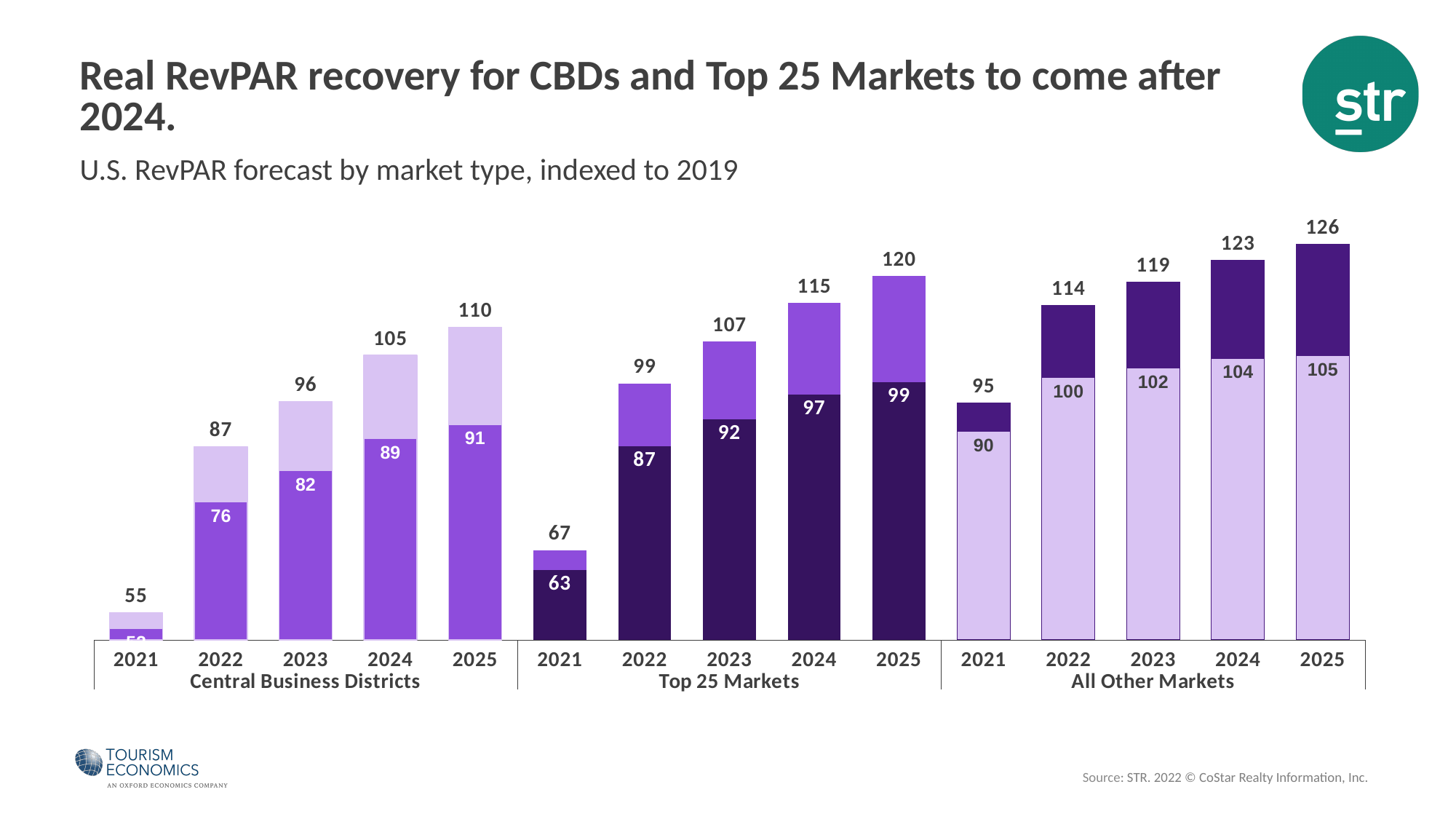
What is the value shown above the 2021 bar for Top 25 Markets? 67 Which is larger: the 2024 total for Central Business Districts or the 2023 total for Top 25 Markets? 2023 total for Top 25 Markets (107) How many market types are shown on the x axis? 3 What is the difference between the total value (120) and the lower segment value (99) of the 2025 bar for Top 25 Markets? 21 What is the difference between the 2025 total for All Other Markets and the 2025 total for Central Business Districts? 16 What is the value shown above the 2024 bar for All Other Markets? 123 What is the total value shown above the 2025 bar for Central Business Districts? 110 Which bar has the highest total value on the chart? All Other Markets 2025 (126) Do the total values for Central Business Districts rise or fall from 2021 to 2025? Rise What kind of chart is shown on the slide? Stacked bar chart Which bar has the lowest total value on the chart? Central Business Districts 2021 (55) What value is printed inside the lower segment of the 2023 bar for Top 25 Markets? 92